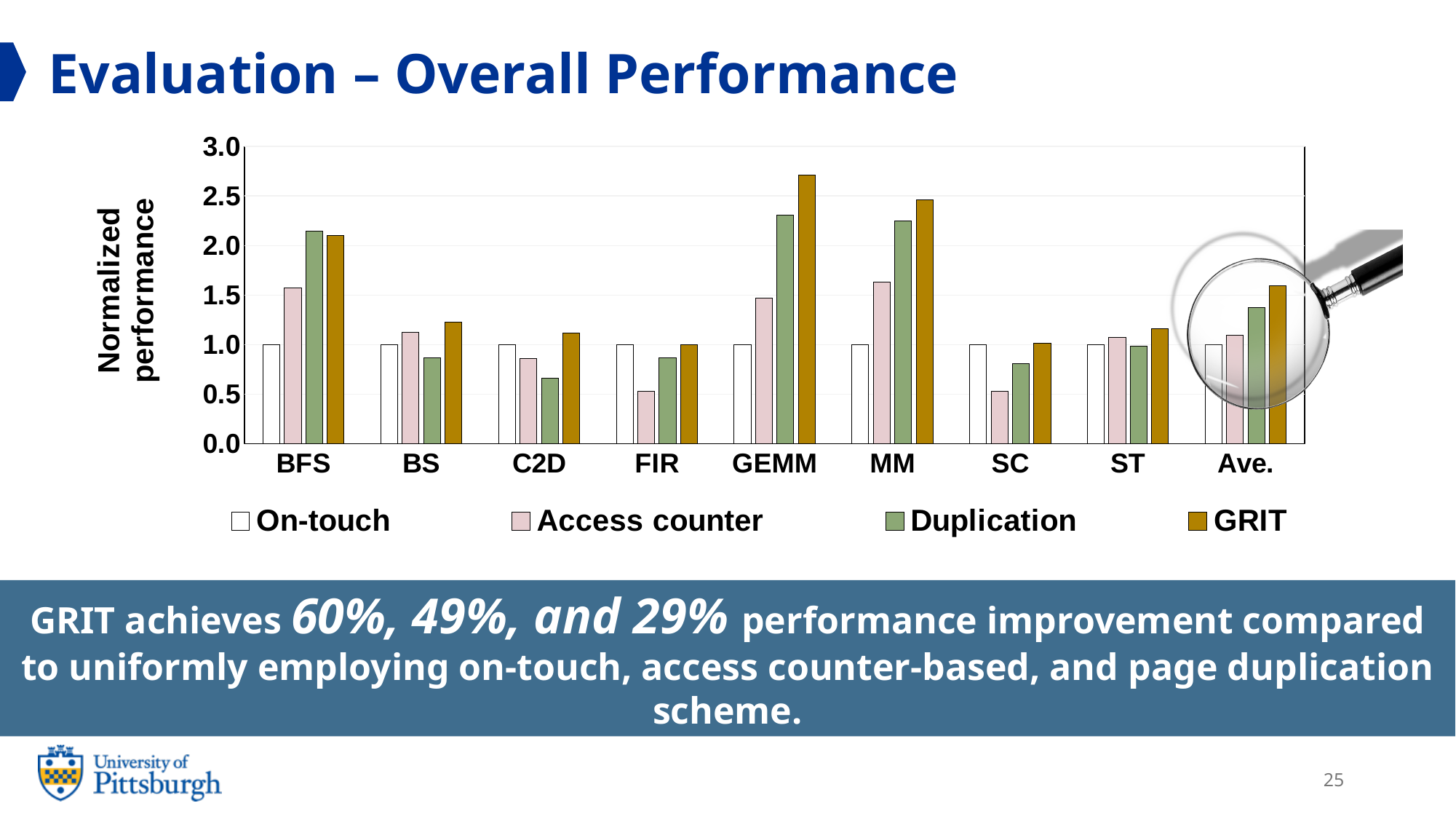
For GEMM, which is larger: the Duplication value or the GRIT value? GRIT What is the normalized performance of On-touch for BFS? 1.0 How many categories are shown along the x axis? 9 What is the label of the y axis? Normalized performance For SC, which is larger: the Access counter value or the Duplication value? Duplication Is the GRIT value for GEMM greater or less than 2.5? greater What kind of chart is shown on the slide? bar chart How many series does the legend list? 4 Is the Access counter value for FIR greater or less than 1.0? less Is the Duplication value for C2D greater or less than 1.0? less For which category is the GRIT bar the highest? GEMM For which category is the Access counter bar the highest? MM